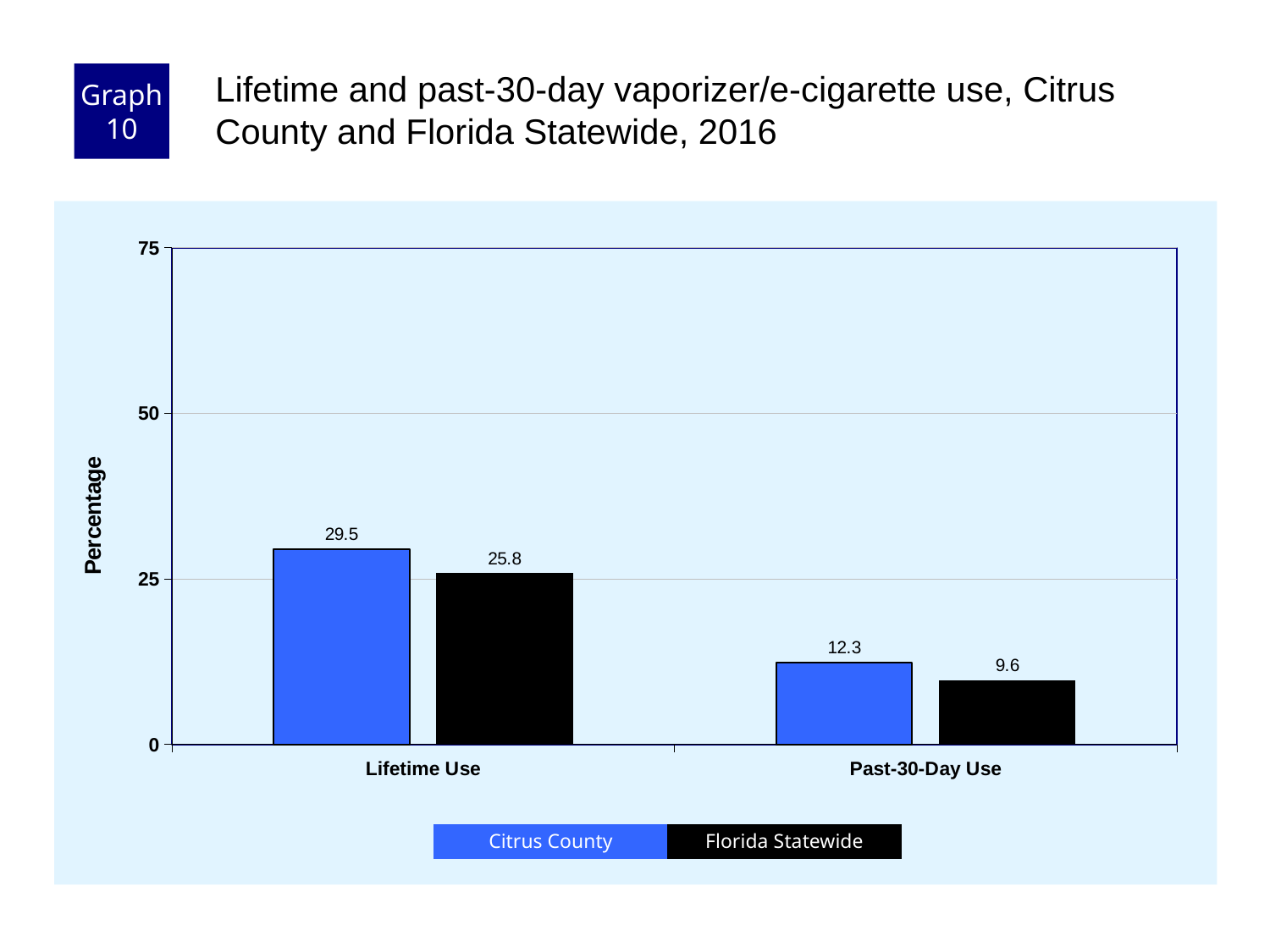
What is the Florida Statewide value for Past-30-Day Use? 9.6 How many series does the legend list? 2 What is the Citrus County value for Lifetime Use? 29.5 Which is larger for Past-30-Day Use, Citrus County or Florida Statewide? Citrus County What is the Florida Statewide value for Lifetime Use? 25.8 Which series has the highest value for Lifetime Use? Citrus County Which category has the lowest Florida Statewide value? Past-30-Day Use What is the difference between the Citrus County and Florida Statewide values for Past-30-Day Use? 2.7 What is the difference between the Citrus County and Florida Statewide values for Lifetime Use? 3.7 Is the Citrus County value for Lifetime Use greater or less than 25? greater What kind of chart is shown on the slide? bar chart How many categories are shown on the x axis? 2